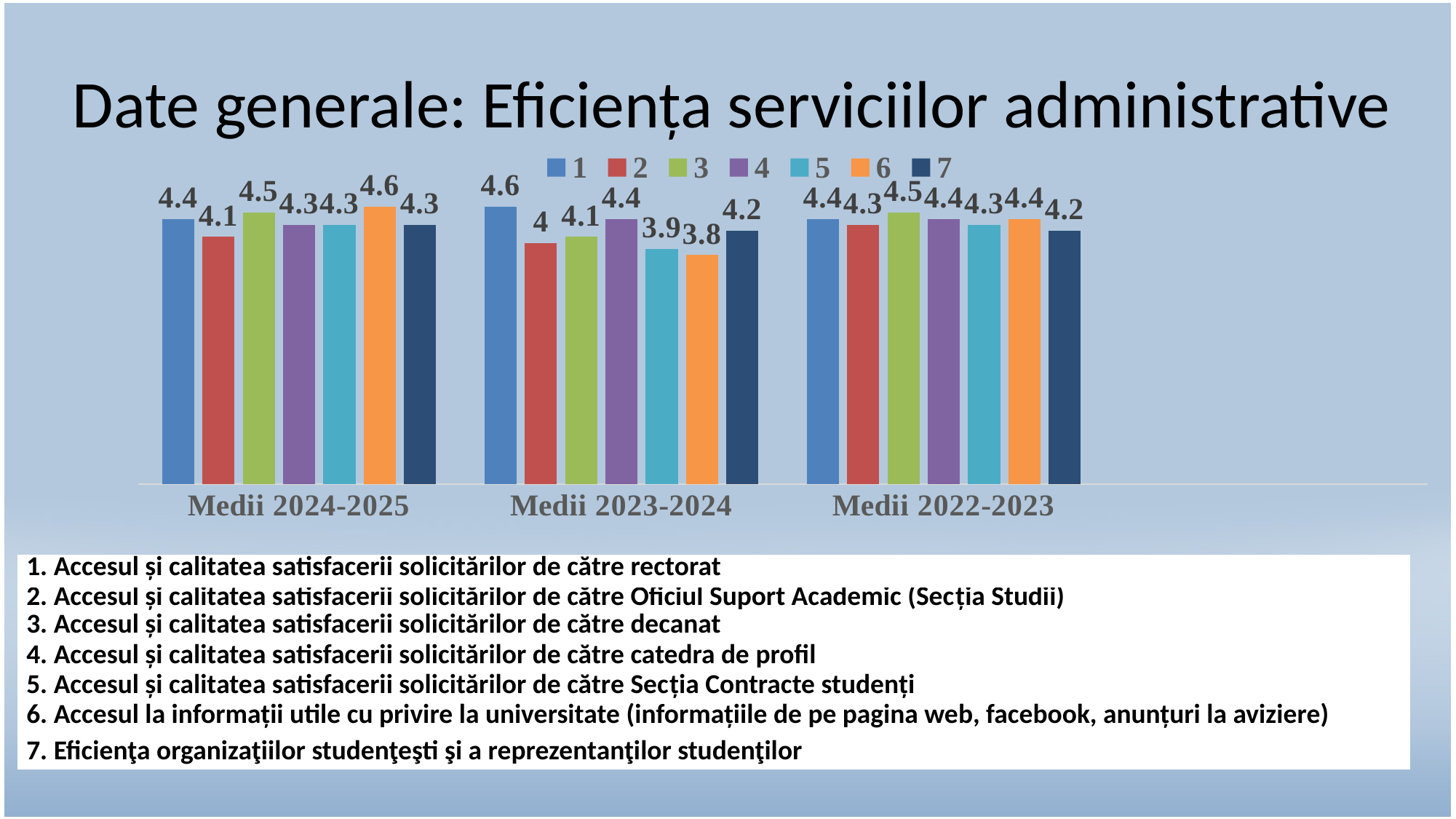
Which series has the highest value in Medii 2024-2025? 6 What is the value for series 5 in Medii 2023-2024? 3.9 How many categories are shown on the x axis? 3 Which is larger in Medii 2024-2025: series 3 or series 2? series 3 What is the value for series 6 in Medii 2024-2025? 4.6 Which series has the lowest value in Medii 2023-2024? 6 What is the difference between series 1 and series 6 in Medii 2023-2024? 0.8 Which series has the highest value in Medii 2022-2023? 3 What is the value for series 1 in Medii 2023-2024? 4.6 What is the value for series 2 in Medii 2022-2023? 4.3 What kind of chart is shown on the slide? bar chart How many series does the legend list? 7